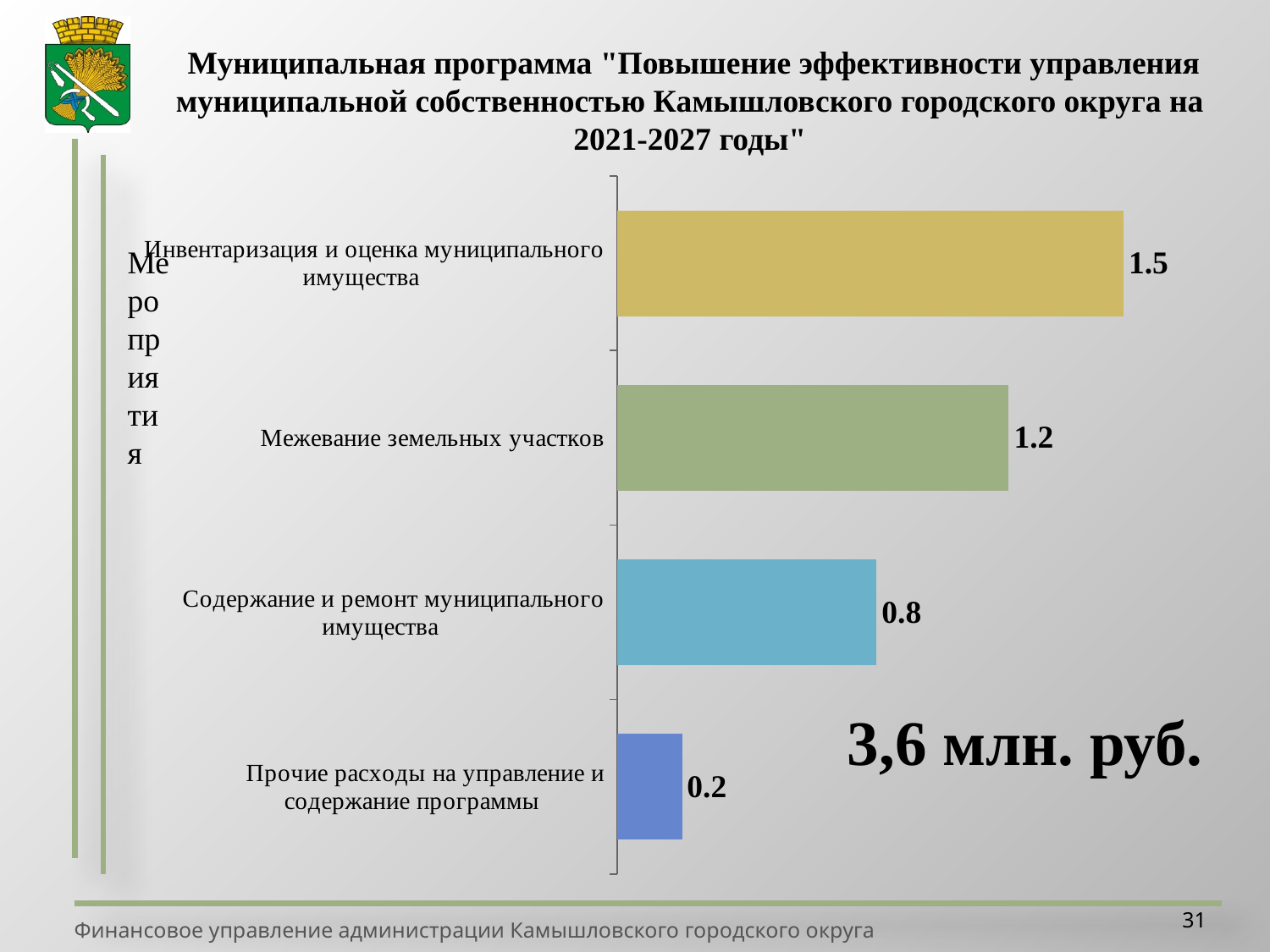
What kind of chart is shown on the slide? Bar chart Which category has the lowest value? Прочие расходы на управление и содержание программы What is the value for "Прочие расходы на управление и содержание программы"? 0.2 What is the difference between the values for "Инвентаризация и оценка муниципального имущества" and "Межевание земельных участков"? 0.3 What is the value for "Инвентаризация и оценка муниципального имущества"? 1.5 What is the value for "Содержание и ремонт муниципального имущества"? 0.8 What total amount is printed on the chart in large text? 3,6 млн. руб. What is the value for "Межевание земельных участков"? 1.2 Which category has the highest value? Инвентаризация и оценка муниципального имущества What is the difference between the values for "Содержание и ремонт муниципального имущества" and "Прочие расходы на управление и содержание программы"? 0.6 How many categories are shown in the chart? 4 Which is larger: the value for "Межевание земельных участков" or the value for "Содержание и ремонт муниципального имущества"? Межевание земельных участков